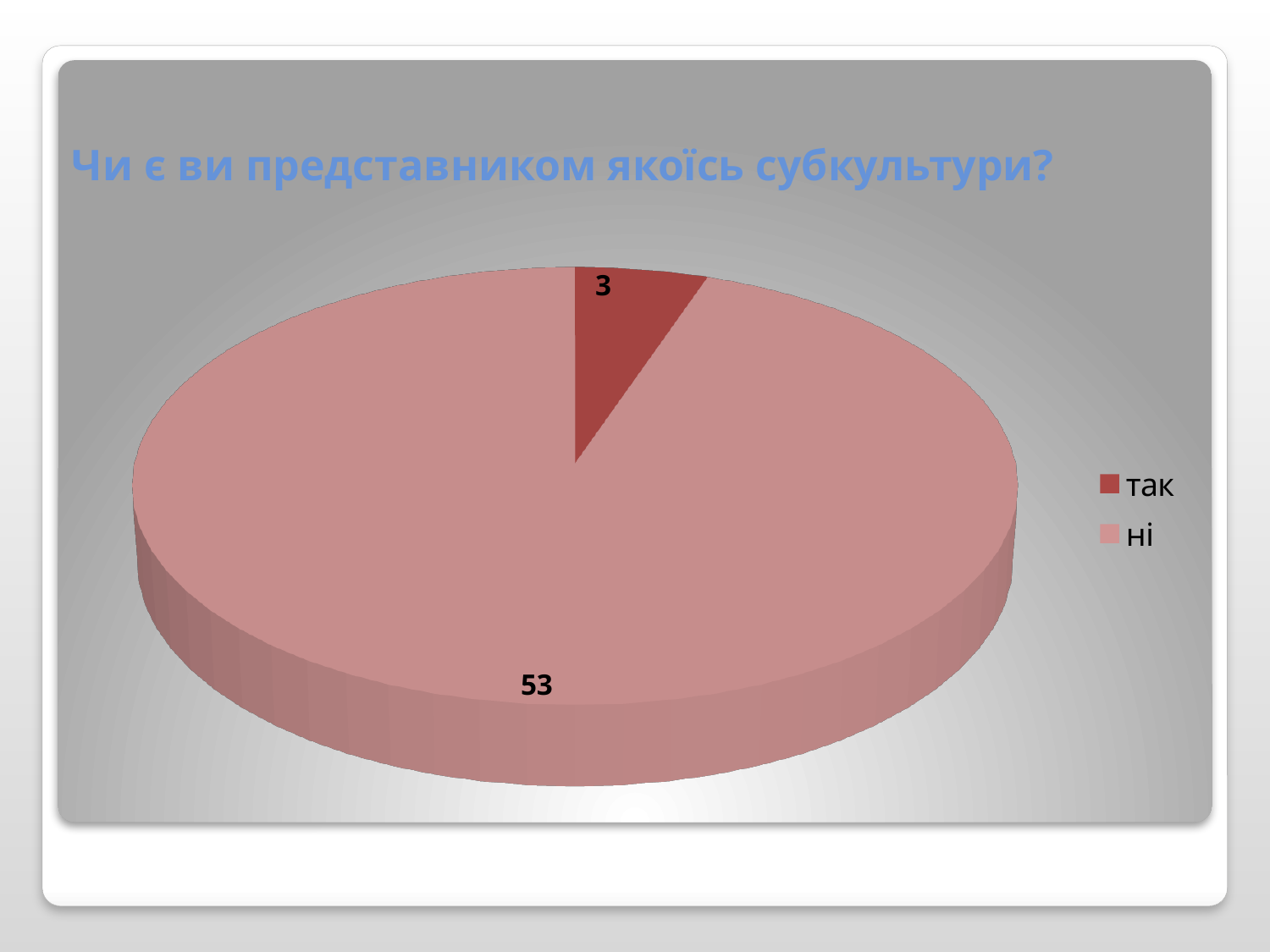
How many entries does the legend list? 2 Which category has the largest slice in the pie chart? ні What is the difference between the values for "ні" and "так"? 50 What is the value for "так" in the pie chart? 3 What is the total of all slices in the pie chart? 56 What kind of chart is shown on the slide? pie chart Which legend entry is shown in the darker red colour? так What is the title of the chart? Чи є ви представником якоїсь субкультури? What is the value for "ні" in the pie chart? 53 Which is larger, the value for "так" or the value for "ні"? ні How many categories does the pie chart have? 2 Which category has the smallest slice in the pie chart? так